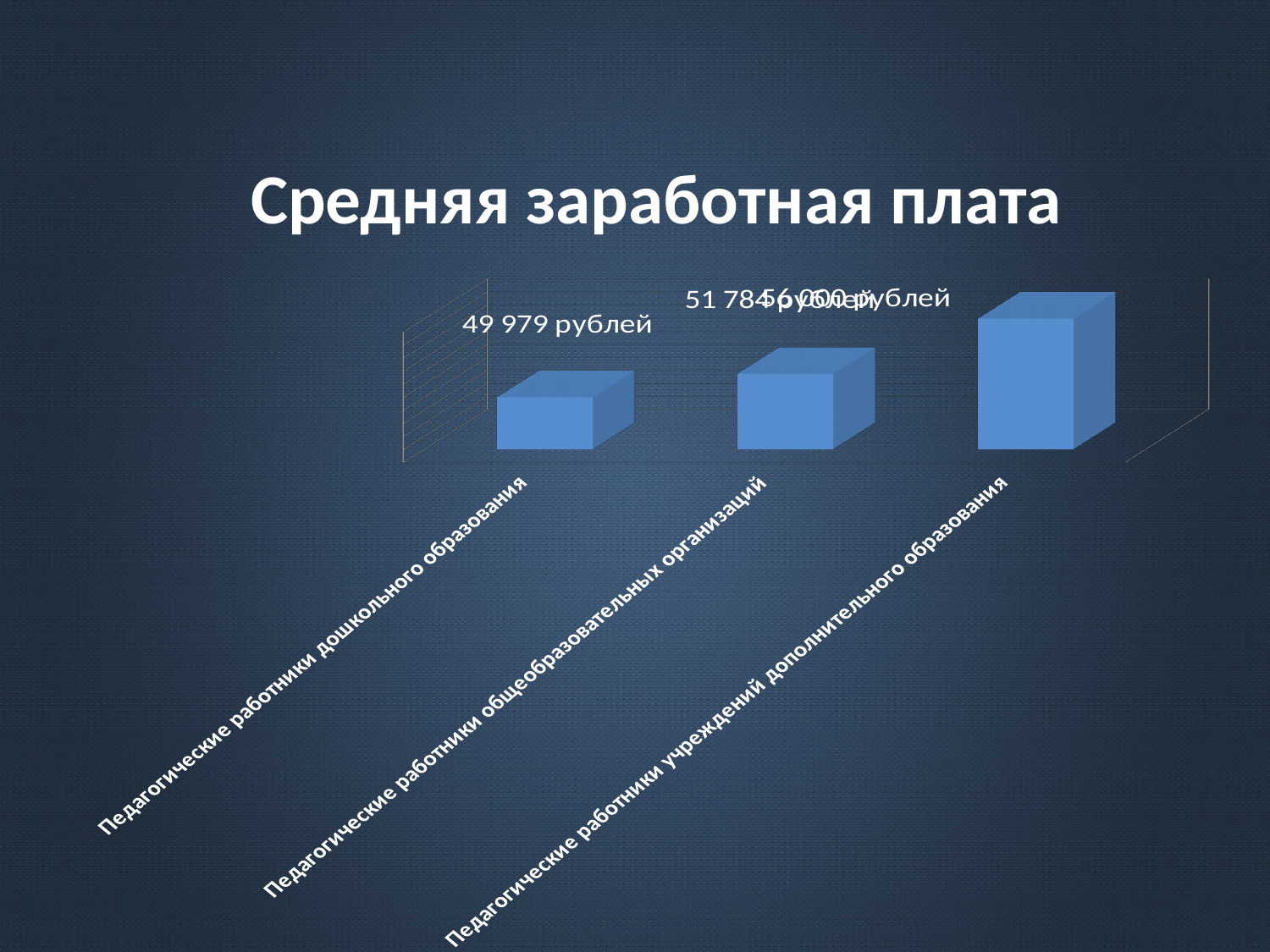
What colour are the bars in the chart? blue Which category has the highest value? Педагогические работники учреждений дополнительного образования Which is larger: the value for Педагогические работники учреждений дополнительного образования or for Педагогические работники общеобразовательных организаций? Педагогические работники учреждений дополнительного образования What kind of chart is shown on the slide? bar chart Which category has the lowest value? Педагогические работники дошкольного образования Do the values rise or fall from left to right across the categories? rise What is the value for Педагогические работники дошкольного образования? 49 979 рублей How many categories are plotted in the chart? 3 Which is larger: the value for Педагогические работники общеобразовательных организаций or for Педагогические работники дошкольного образования? Педагогические работники общеобразовательных организаций What is the title of the chart? Средняя заработная плата